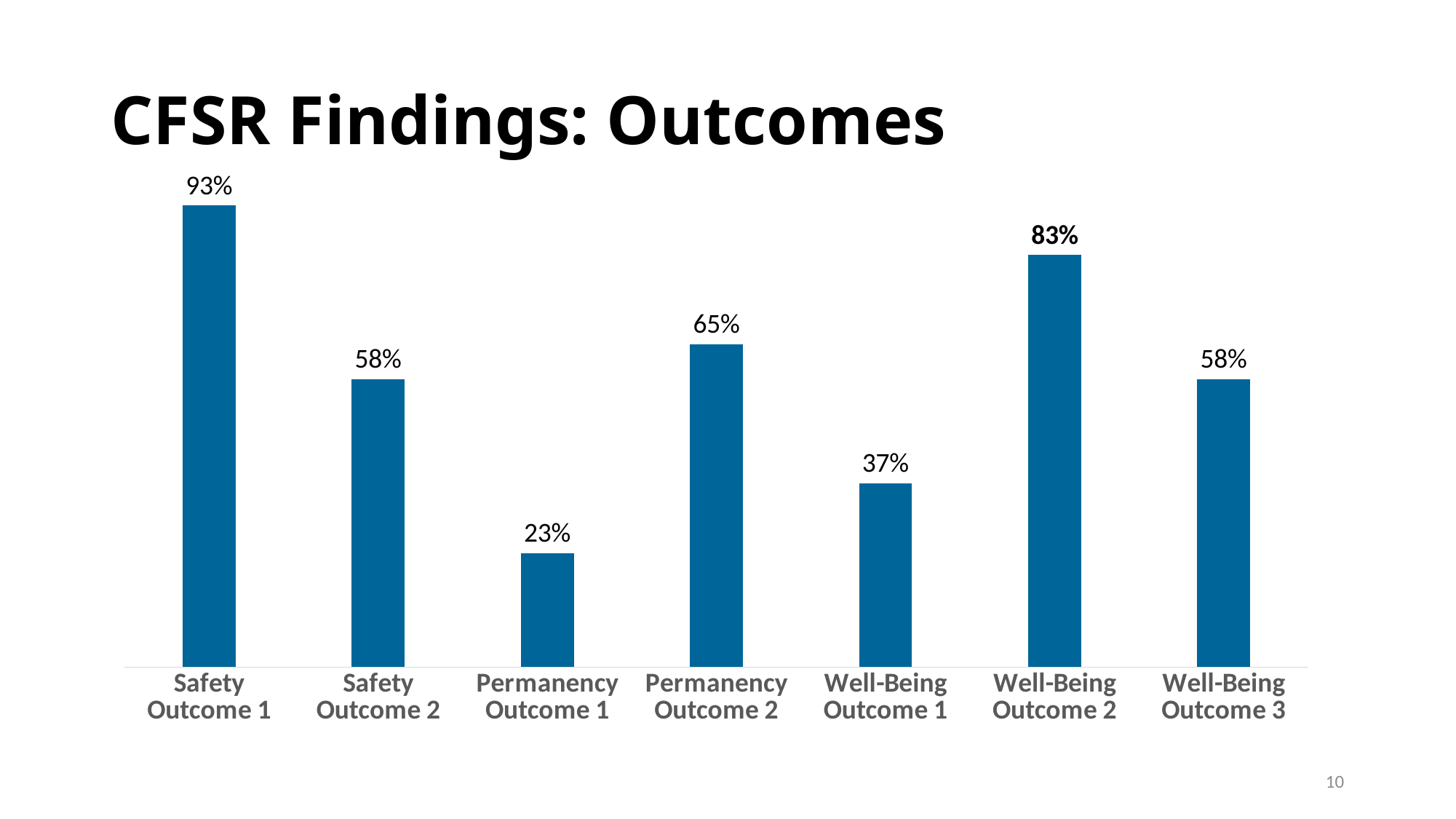
What is the difference between Well-Being Outcome 2 and Well-Being Outcome 1? 46% What is the title of the slide? CFSR Findings: Outcomes How many categories are shown in the chart? 7 What is the value for Well-Being Outcome 2? 83% Which is larger, Permanency Outcome 2 or Well-Being Outcome 3? Permanency Outcome 2 Which category has the highest value? Safety Outcome 1 What kind of chart is shown on the slide? Bar chart What is the value for Safety Outcome 1? 93% What is the value for Permanency Outcome 1? 23% What is the difference between Safety Outcome 1 and Safety Outcome 2? 35% Which category has the lowest value? Permanency Outcome 1 What is the value for Well-Being Outcome 1? 37%